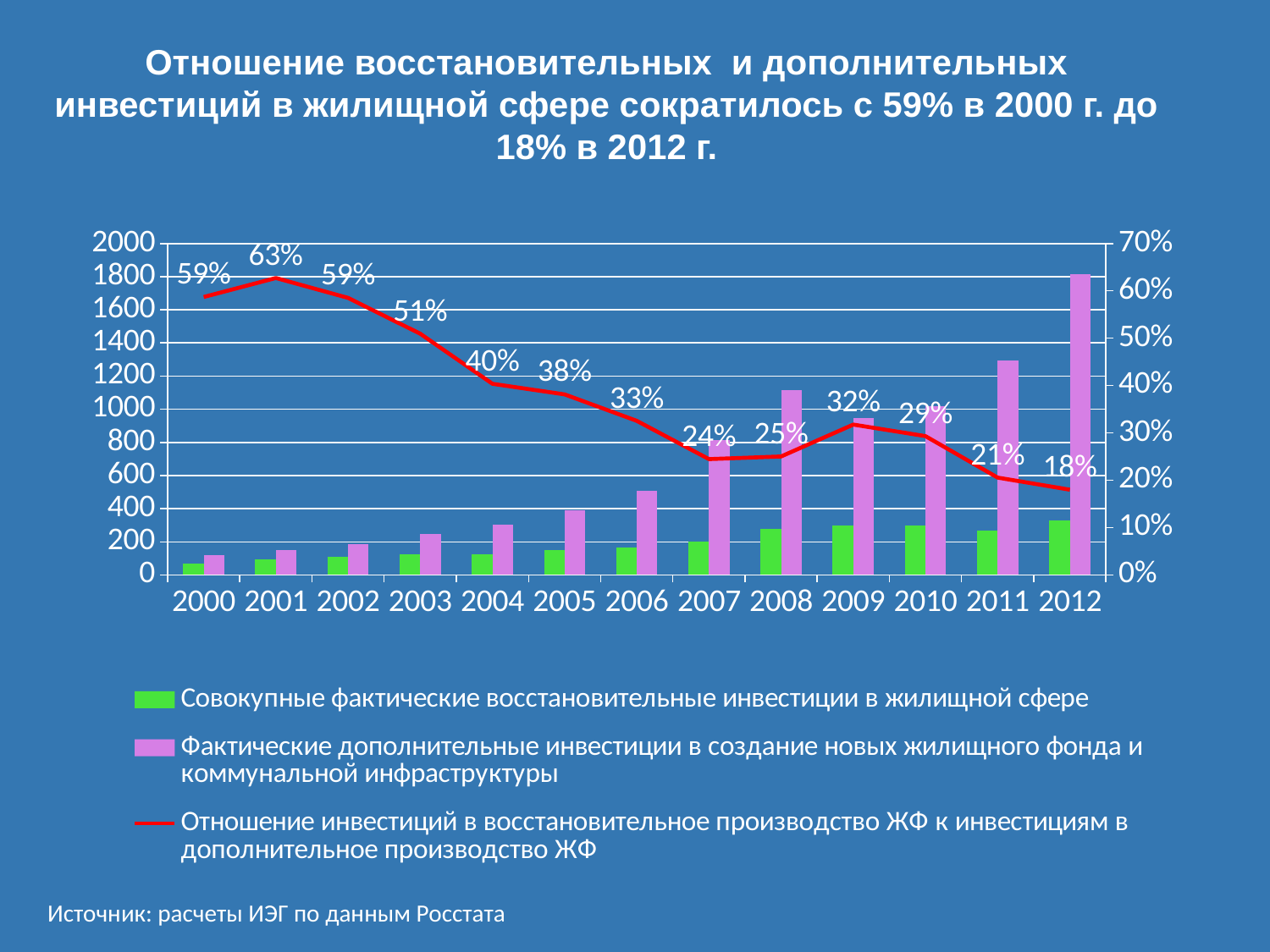
How many series does the legend list? 3 What is the value of the ratio line for 2004? 40% Does the ratio line rise or fall between 2001 and 2007? fall By how many percentage points did the ratio line fall from 2001 to 2012? 45 percentage points What is the value of the ratio line (Отношение инвестиций) for 2000? 59% How many years are shown on the x axis? 13 What is the value of the ratio line for 2012? 18% Is the value of the purple bar (Фактические дополнительные инвестиции) for 2012 greater or less than 1600? greater Is the value of the green bar (Совокупные фактические восстановительные инвестиции) for 2012 greater or less than 400? less In which year does the ratio line reach its highest value? 2001 Which year has the larger ratio value, 2007 or 2008? 2008 In which year does the ratio line reach its lowest value? 2012